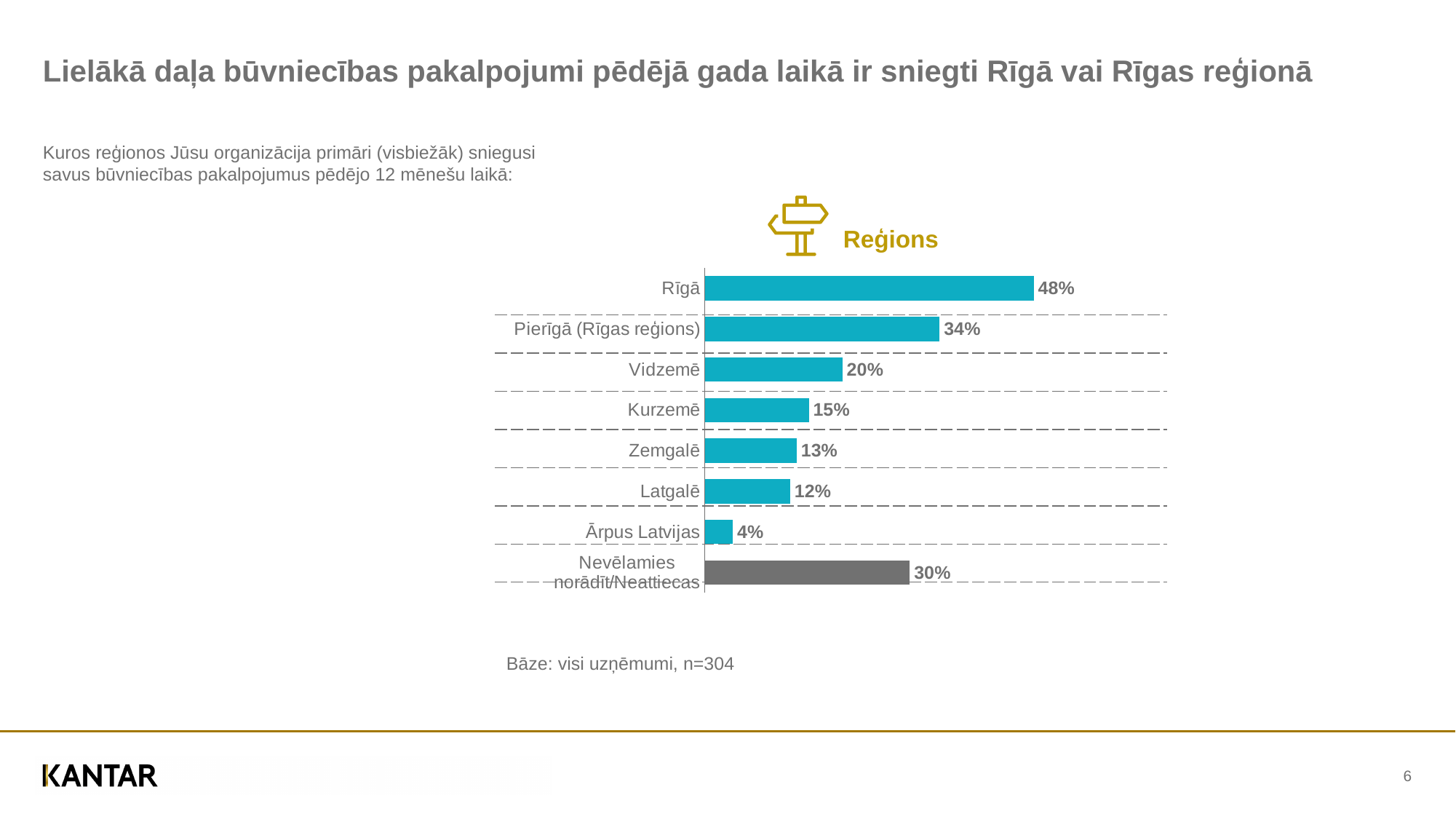
How many categories are shown in the chart? 8 What is the difference between the values for Rīgā and Pierīgā (Rīgas reģions)? 14% What is the value for Nevēlamies norādīt/Neattiecas? 30% What is the difference between the values for Vidzemē and Latgalē? 8% What is the value for Kurzemē? 15% Which category has the lowest value? Ārpus Latvijas What is the value for Pierīgā (Rīgas reģions)? 34% What kind of chart is shown on the slide? Bar chart What is the title shown above the chart? Reģions Which is larger, the value for Zemgalē or the value for Latgalē? Zemgalē What is the value for Rīgā? 48% Which category has the highest value? Rīgā